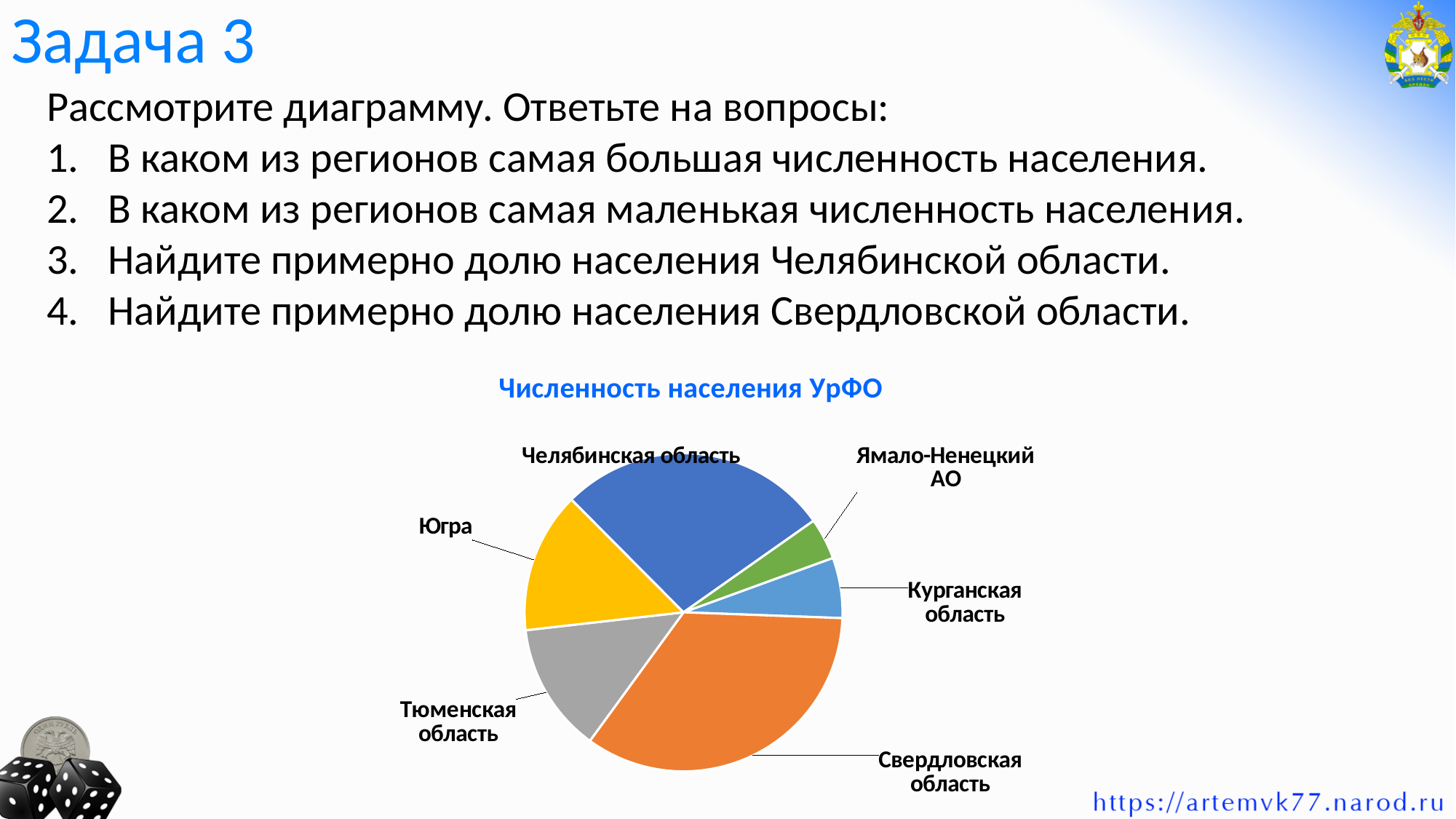
Which region is represented by the orange slice? Свердловская область Which region has the largest slice of the pie chart? Свердловская область How many regions (slices) does the pie chart show? 6 Which slice is larger: Челябинская область or Югра? Челябинская область What is the title of the chart? Численность населения УрФО Which region has the smallest slice of the pie chart? Ямало-Ненецкий АО Which slice is larger: Свердловская область or Челябинская область? Свердловская область Which slice is larger: Ямало-Ненецкий АО or Тюменская область? Тюменская область What kind of chart is shown on the slide? pie chart